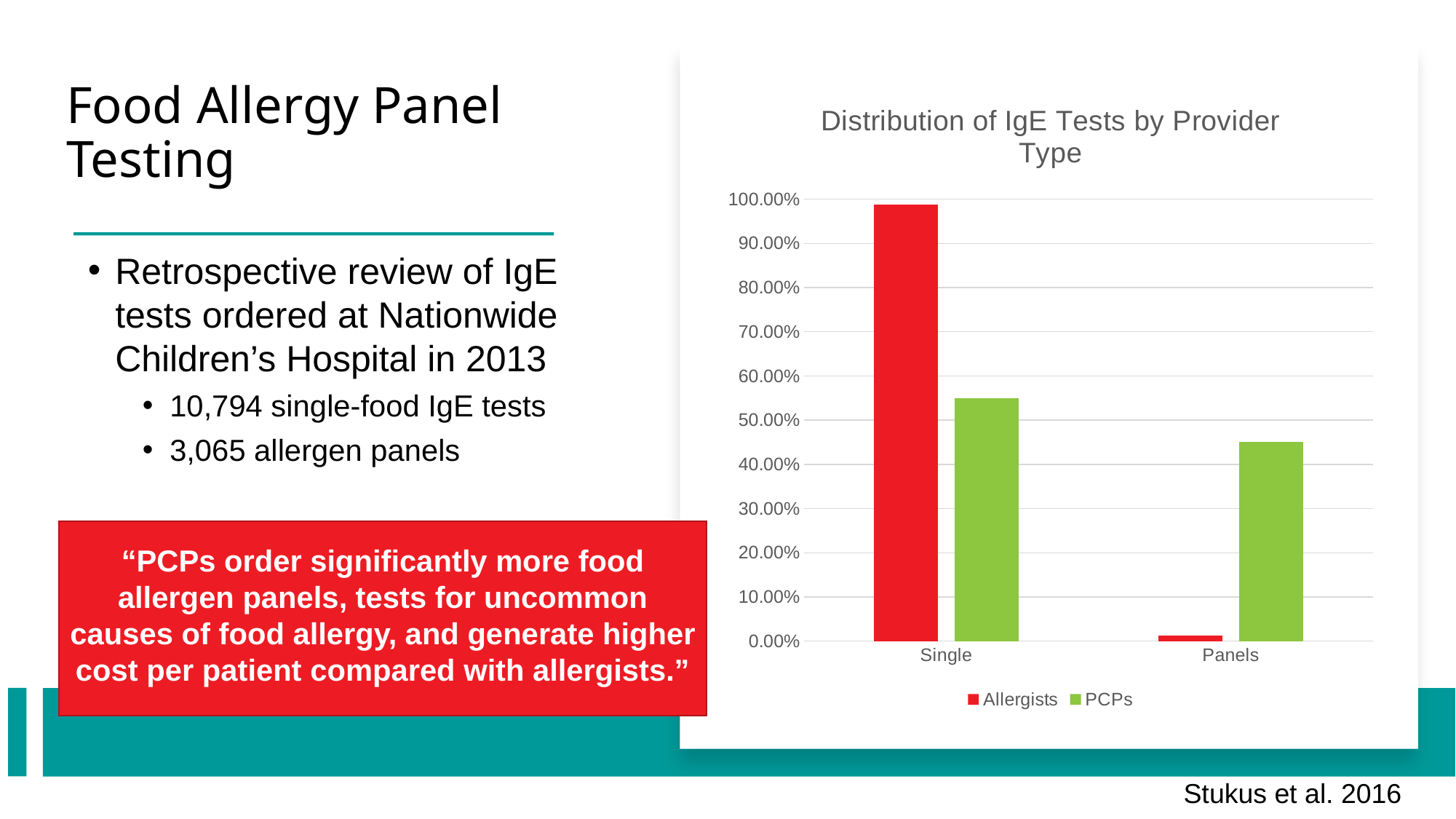
How many series does the chart legend list? 2 Which series is shown in red in the chart? Allergists What is the title of the chart? Distribution of IgE Tests by Provider Type Which series has the higher value in the Single category? Allergists Is the value for Allergists in the Panels category greater or less than 10.00%? less How many categories are shown on the x axis of the chart? 2 Is the value for PCPs in the Panels category greater or less than 40.00%? greater Which category has the lowest value for the Allergists series? Panels Is the value for Allergists in the Single category greater or less than 90.00%? greater What kind of chart is shown on the slide? bar chart Which series has the higher value in the Panels category? PCPs